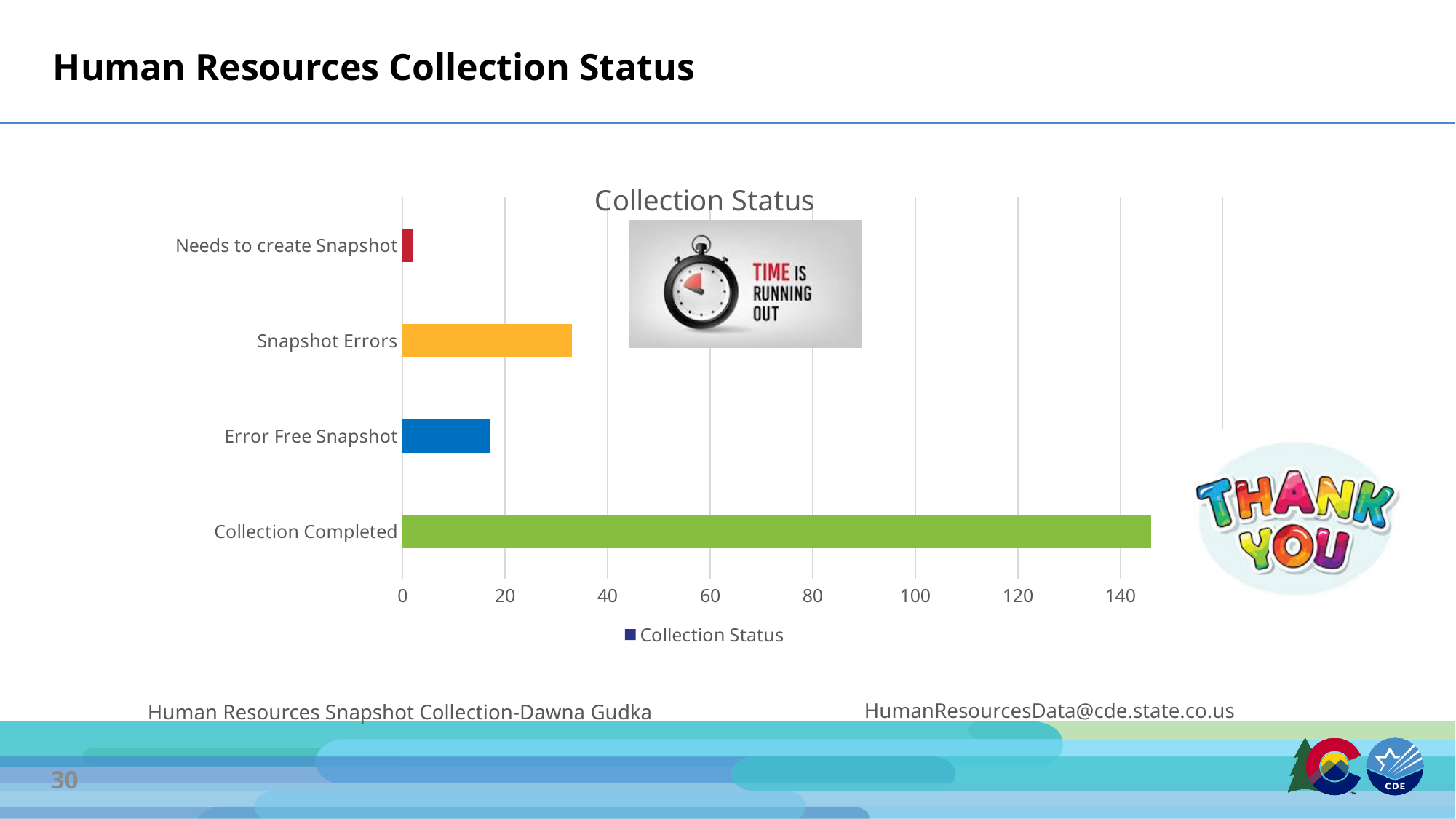
Is the value for Collection Completed greater or less than 140? greater Which is larger, the value for Snapshot Errors or the value for Error Free Snapshot? Snapshot Errors Which category has the highest value? Collection Completed What kind of chart is shown on the slide? bar chart How many categories are plotted in the chart? 4 What is the name of the series shown in the legend? Collection Status How many series does the legend list? 1 Is the value for Error Free Snapshot greater or less than 20? less Is the value for Snapshot Errors greater or less than 40? less What is the title of the chart? Collection Status Which category has the lowest value? Needs to create Snapshot